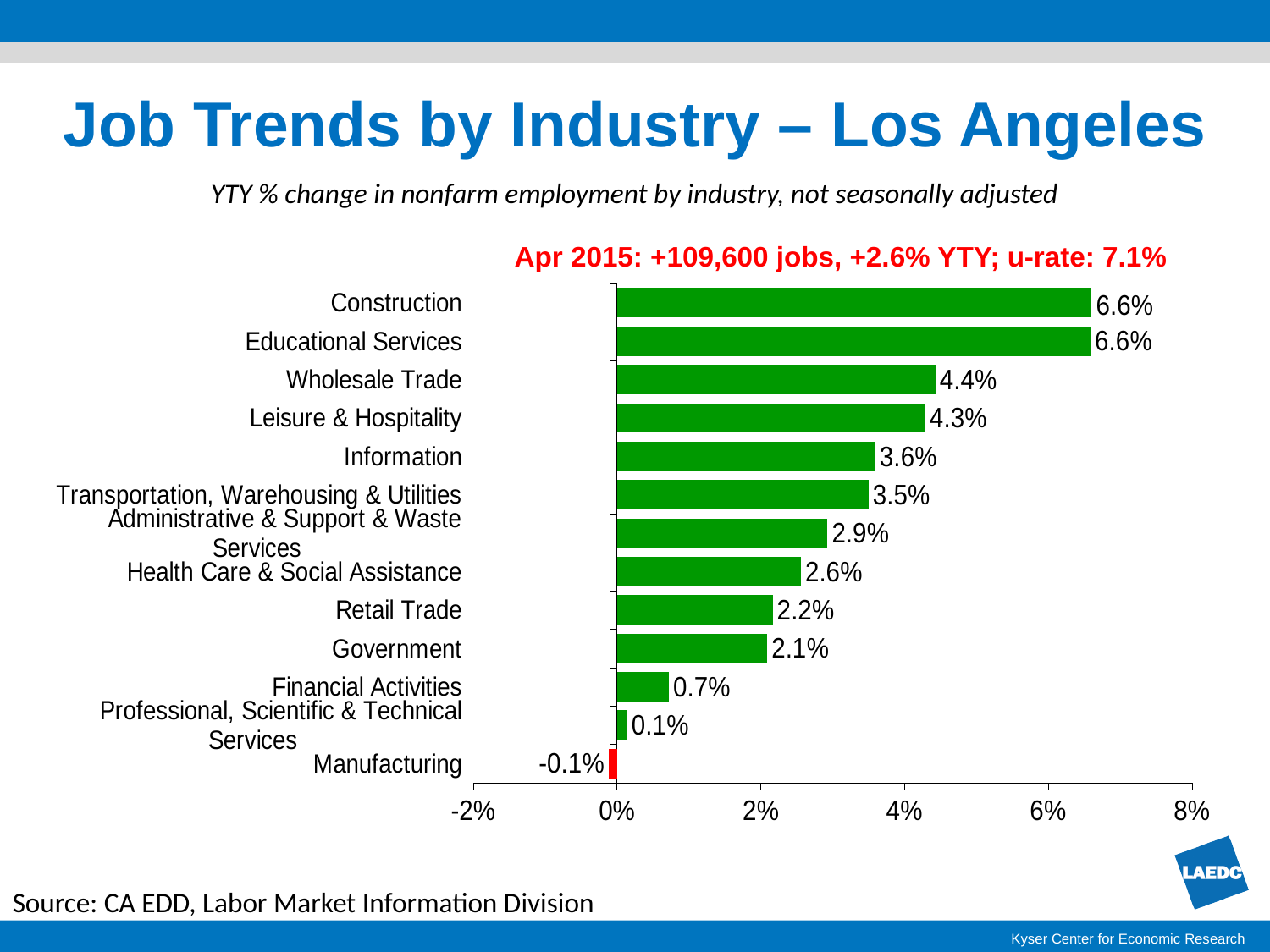
Which industry has the lowest YTY % change? Manufacturing Which industry's bar is coloured red? Manufacturing What is the difference between Construction and Government? 4.5% What is the difference between the values for Wholesale Trade and Retail Trade? 2.2% What type of chart is shown on the slide? Bar chart What is the YTY % change in employment for Wholesale Trade? 4.4% Which is larger, the value for Leisure & Hospitality or the value for Transportation, Warehousing & Utilities? Leisure & Hospitality What value is shown for Health Care & Social Assistance? 2.6% How many industries are shown in the chart? 13 What is the value shown for Information? 3.6% What is the value shown for Financial Activities? 0.7% What is the YTY % change for Manufacturing? -0.1%